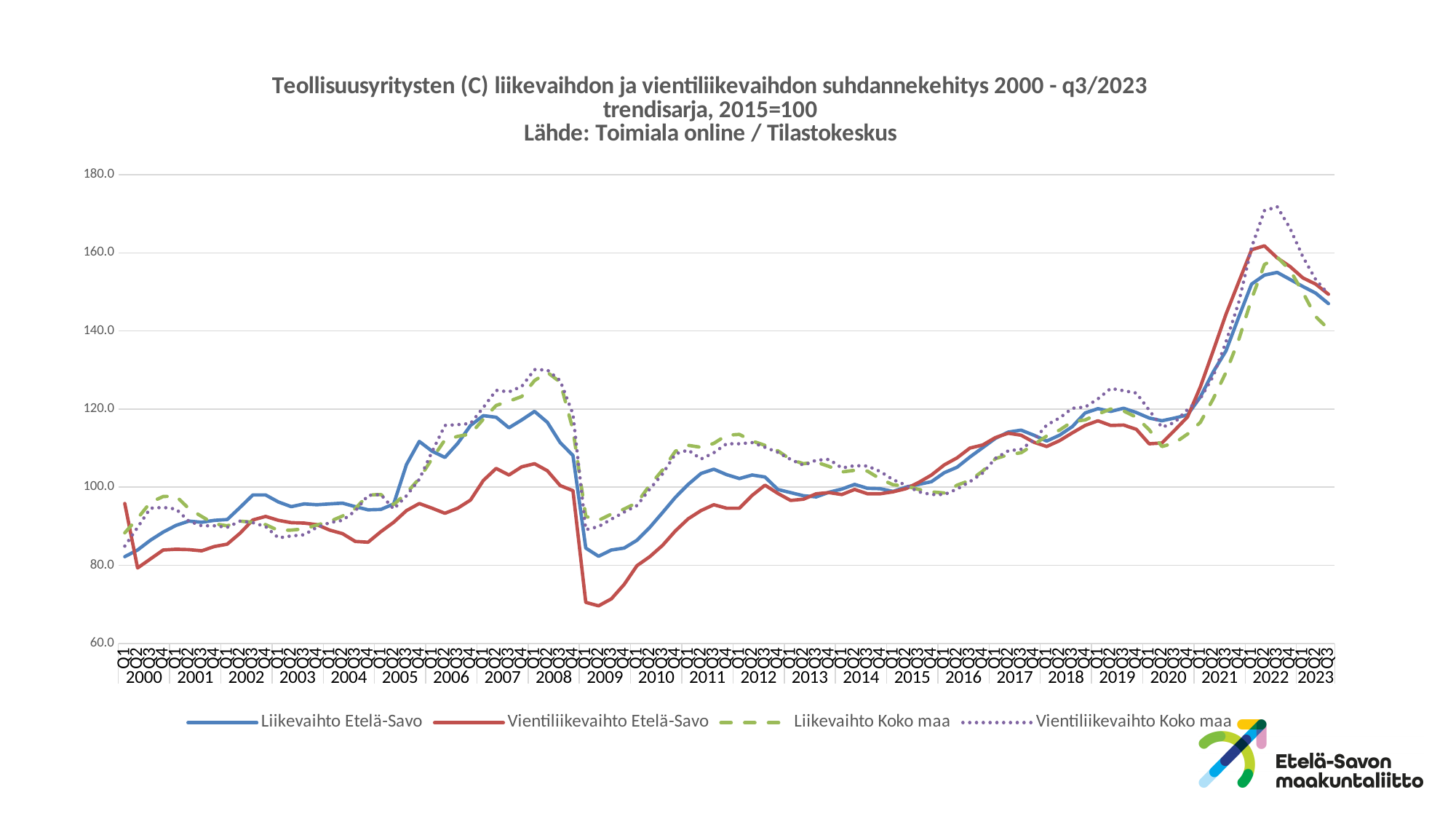
Is the value for Vientiliikevaihto Etelä-Savo in Q2 2008 greater or less than 100? greater According to the chart title, which year is the index base (=100)? 2015 Which series is drawn as a green dashed line? Liikevaihto Koko maa How many series does the legend list? 4 Is the value for Vientiliikevaihto Etelä-Savo in Q2 2009 greater or less than 80? less In Q2 2009, which is higher: Liikevaihto Etelä-Savo or Vientiliikevaihto Etelä-Savo? Liikevaihto Etelä-Savo Which series reaches the highest peak on the chart? Vientiliikevaihto Koko maa Is the value for Vientiliikevaihto Koko maa in Q3 2022 greater or less than 160? greater What kind of chart is shown on the slide? line chart In Q3 2022, which is higher: Vientiliikevaihto Koko maa or Liikevaihto Etelä-Savo? Vientiliikevaihto Koko maa Does Vientiliikevaihto Etelä-Savo rise or fall from Q4 2020 to Q3 2022? rise